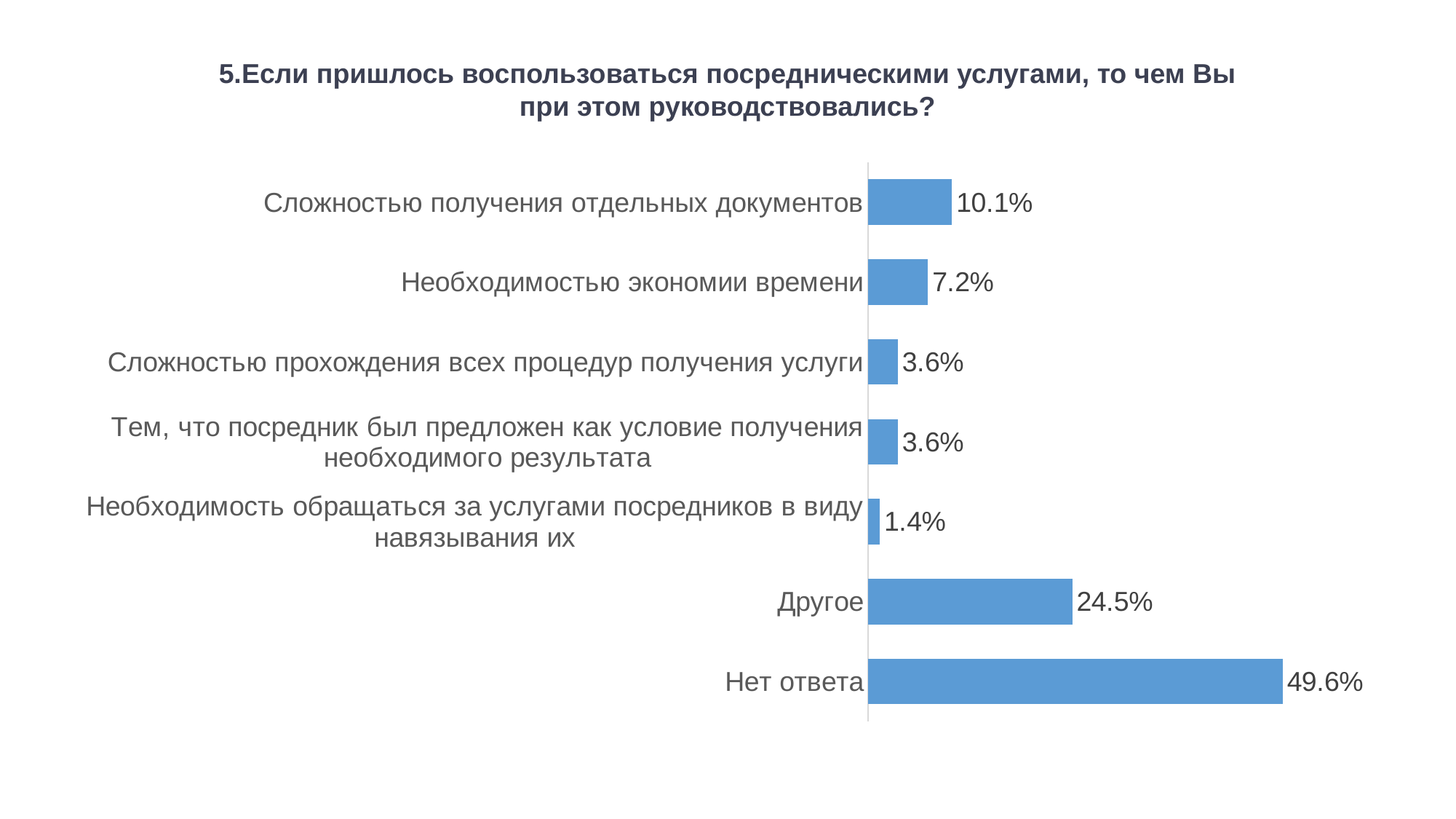
Which is larger, the value for "Другое" or the value for "Сложностью получения отдельных документов"? Другое What colour are the bars in the chart? Blue What is the difference between the values for "Нет ответа" and "Другое"? 25.1% Which category has the highest value? Нет ответа What is the value for "Сложностью получения отдельных документов"? 10.1% What is the difference between the values for "Сложностью получения отдельных документов" and "Необходимостью экономии времени"? 2.9% What kind of chart is shown on the slide? Bar chart What is the value for "Необходимостью экономии времени"? 7.2% What is the value for "Другое"? 24.5% What is the value for "Нет ответа"? 49.6% Which category has the lowest value? Необходимость обращаться за услугами посредников в виду навязывания их How many categories are shown in the chart? 7